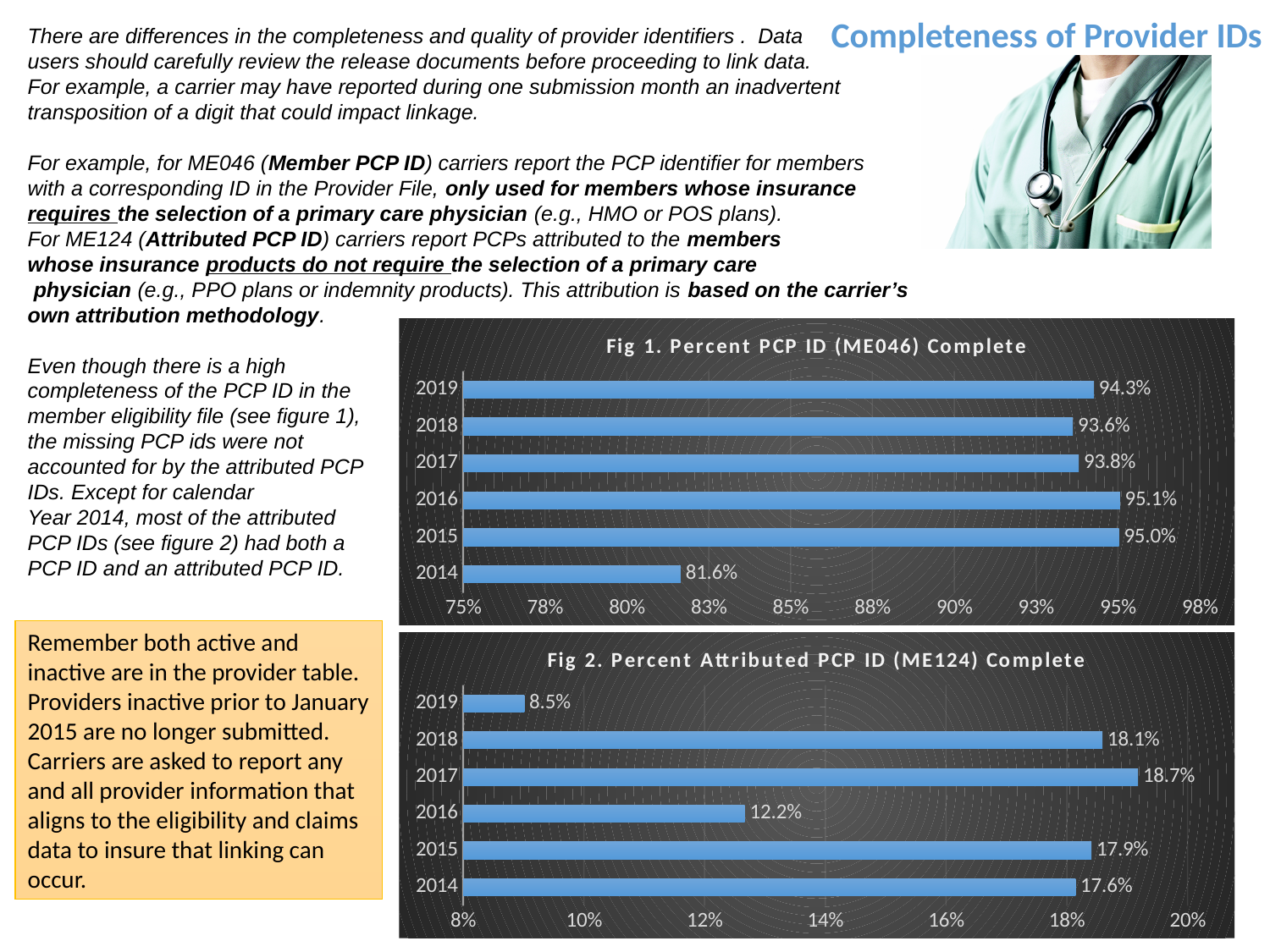
In Fig 1. Percent PCP ID (ME046) Complete, which year has the highest value? 2016 What is the title of the lower chart on the slide? Fig 2. Percent Attributed PCP ID (ME124) Complete In Fig 1. Percent PCP ID (ME046) Complete, what is the difference between the 2019 value and the 2014 value? 12.7% In Fig 2. Percent Attributed PCP ID (ME124) Complete, what is the difference between the 2018 value and the 2019 value? 9.6% In Fig 2. Percent Attributed PCP ID (ME124) Complete, which year has the lowest value? 2019 In Fig 2. Percent Attributed PCP ID (ME124) Complete, what is the value for 2017? 18.7% In Fig 2. Percent Attributed PCP ID (ME124) Complete, which year has the highest value? 2017 In Fig 1. Percent PCP ID (ME046) Complete, what is the value for 2014? 81.6% In Fig 1. Percent PCP ID (ME046) Complete, which year has the lowest value? 2014 What kind of chart is Fig 1. Percent PCP ID (ME046) Complete? Bar chart In Fig 2. Percent Attributed PCP ID (ME124) Complete, which is larger, the value for 2016 or the value for 2015? 2015 In Fig 1. Percent PCP ID (ME046) Complete, how many years are plotted? 6